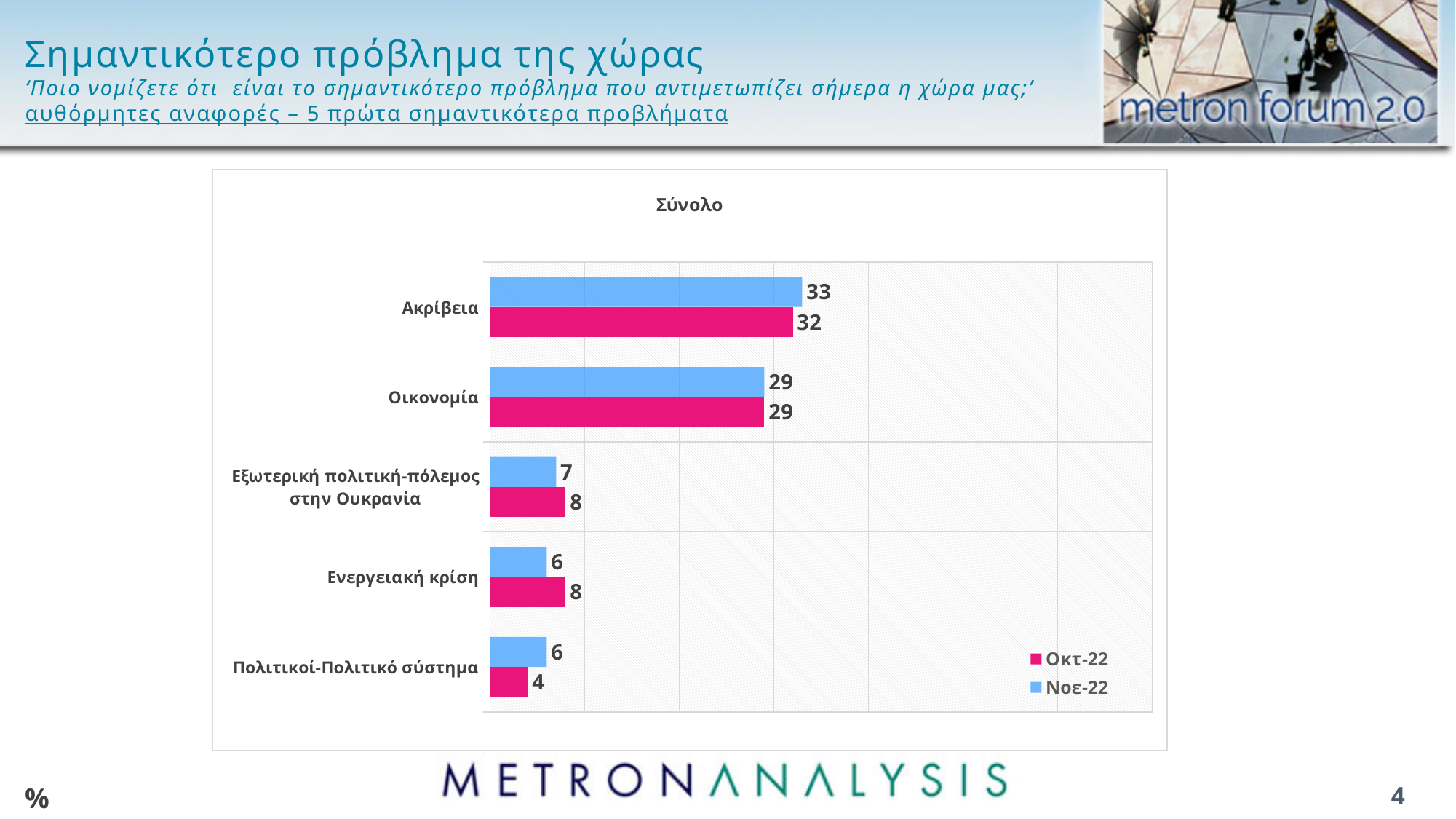
Which category has the lowest value in the Οκτ-22 series? Πολιτικοί-Πολιτικό σύστημα What is the value for Ακρίβεια in the Οκτ-22 series? 32 What is the value for Πολιτικοί-Πολιτικό σύστημα in the Οκτ-22 series? 4 Which category has the highest value in the Νοε-22 series? Ακρίβεια What is the value for Ακρίβεια in the Νοε-22 series? 33 What kind of chart is shown on the slide? Bar chart What is the title of the chart? Σύνολο How many categories are shown on the chart? 5 What is the difference between the Οκτ-22 and Νοε-22 values for Ενεργειακή κρίση? 2 For Πολιτικοί-Πολιτικό σύστημα, which series has the larger value, Οκτ-22 or Νοε-22? Νοε-22 How many series does the legend list? 2 What is the value for Ενεργειακή κρίση in the Νοε-22 series? 6